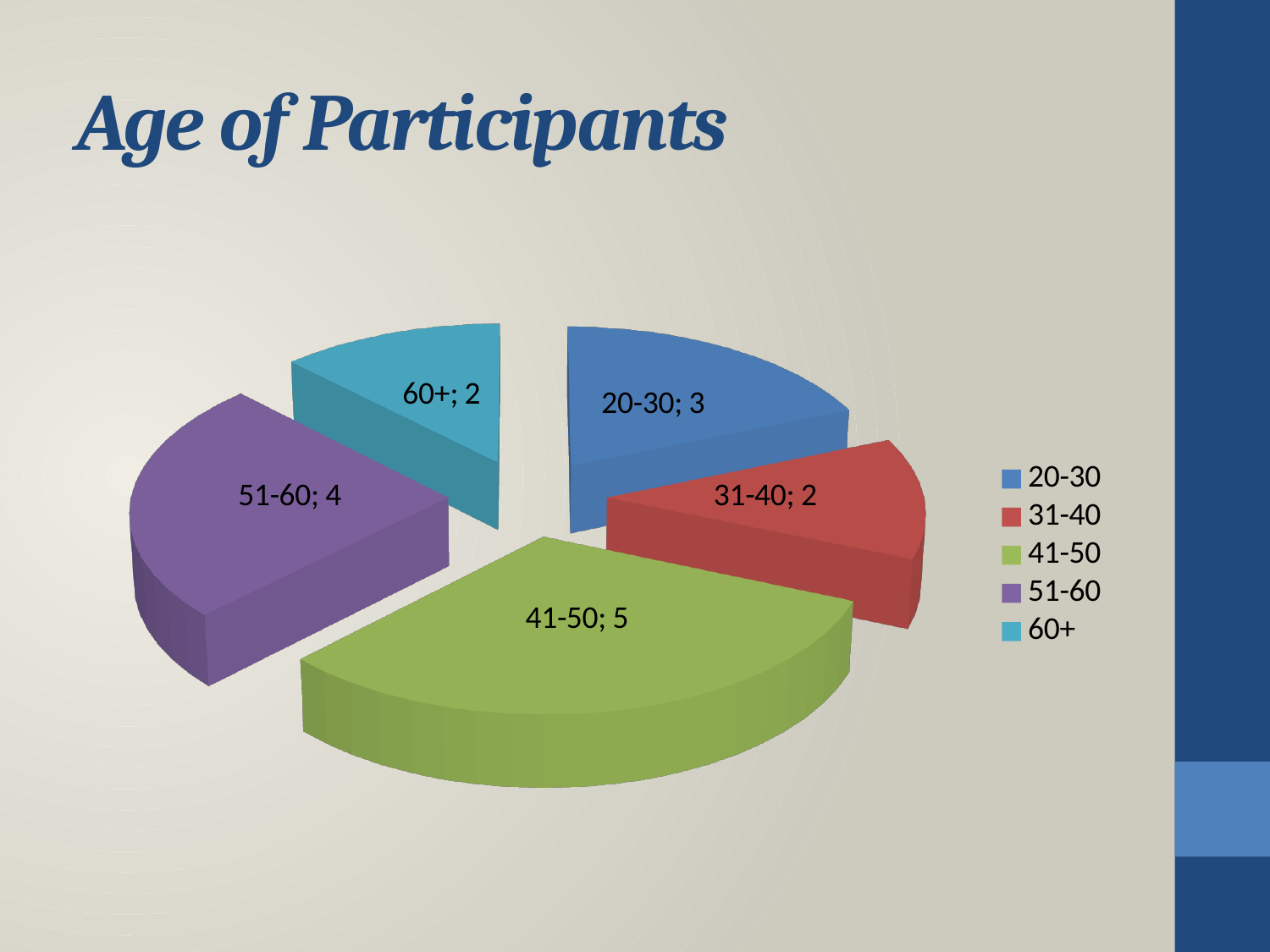
What is the value for the 51-60 age group? 4 What is the value for the 41-50 age group? 5 What kind of chart is shown on the slide? Pie chart What share of the pie does the 41-50 slice represent? 5 out of 16 (31.25%) What is the value for the 20-30 age group? 3 How many age groups are shown in the pie chart? 5 What is the total of all the slices in the pie chart? 16 What colour is the 51-60 slice? Purple Which is larger, the value for 51-60 or the value for 20-30? 51-60 Which age group has the highest value? 41-50 What is the title of the slide? Age of Participants What is the difference between the values for 41-50 and 31-40? 3